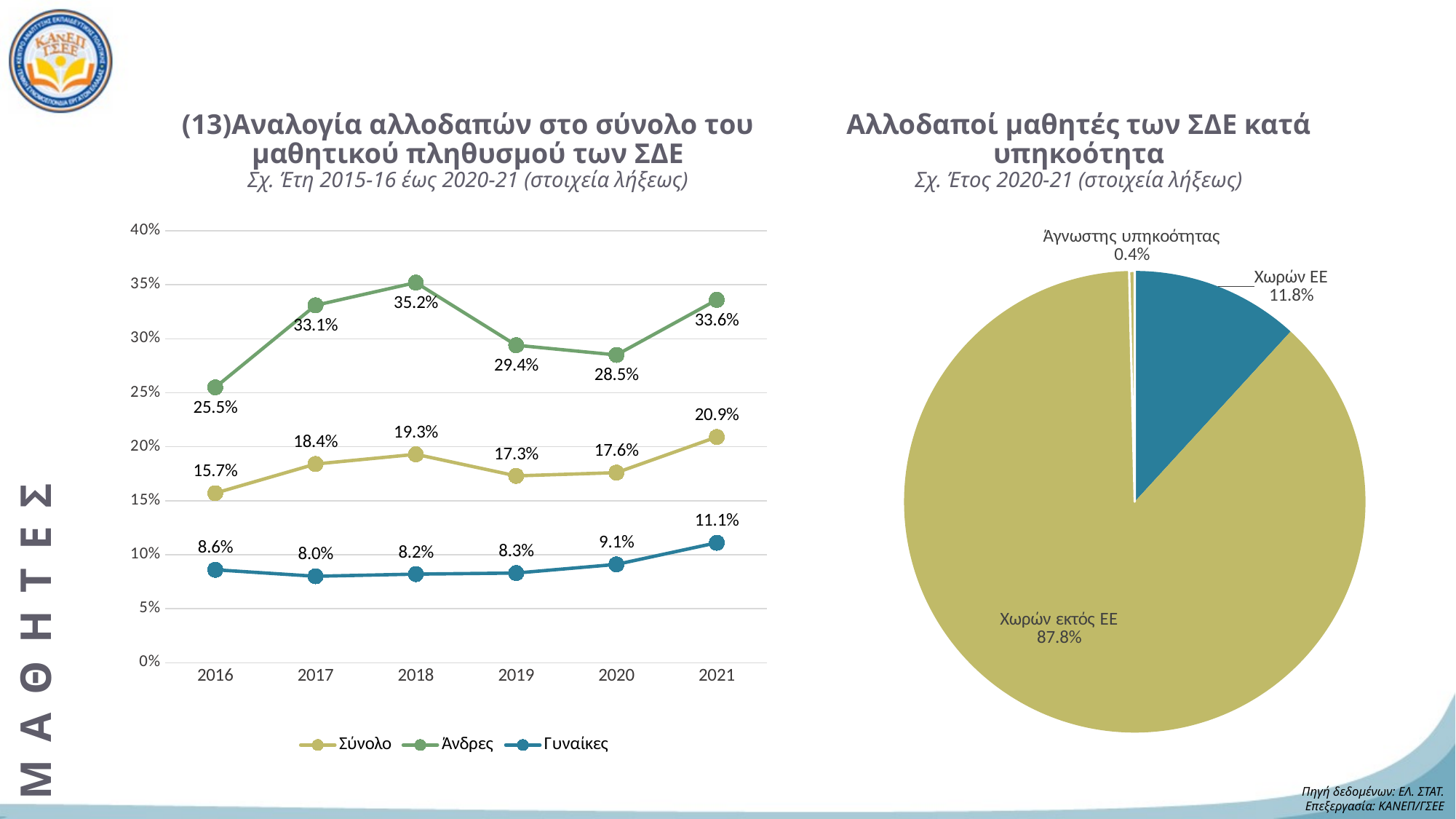
In the left chart (Αναλογία αλλοδαπών στο σύνολο του μαθητικού πληθυσμού των ΣΔΕ), what is the value for Άνδρες in 2018? 35.2% In the left chart, what is the difference between the Άνδρες and Γυναίκες values in 2021? 22.5% In the left chart, in which year is the Άνδρες series highest? 2018 What kind of chart is the chart on the right (Αλλοδαποί μαθητές των ΣΔΕ κατά υπηκοότητα)? pie chart In the left chart, in which year is the Σύνολο series lowest? 2016 In the right pie chart, which slice is the largest? Χωρών εκτός ΕΕ In the right pie chart, what share is Χωρών ΕΕ? 11.8% In the left chart, how many series does the legend list? 3 In the left chart, what is the value for Σύνολο in 2021? 20.9% In the left chart, what is the value for Γυναίκες in 2017? 8.0% In the left chart, which is larger: the Σύνολο value in 2017 or in 2019? 2017 In the left chart, how many years are shown on the x axis? 6